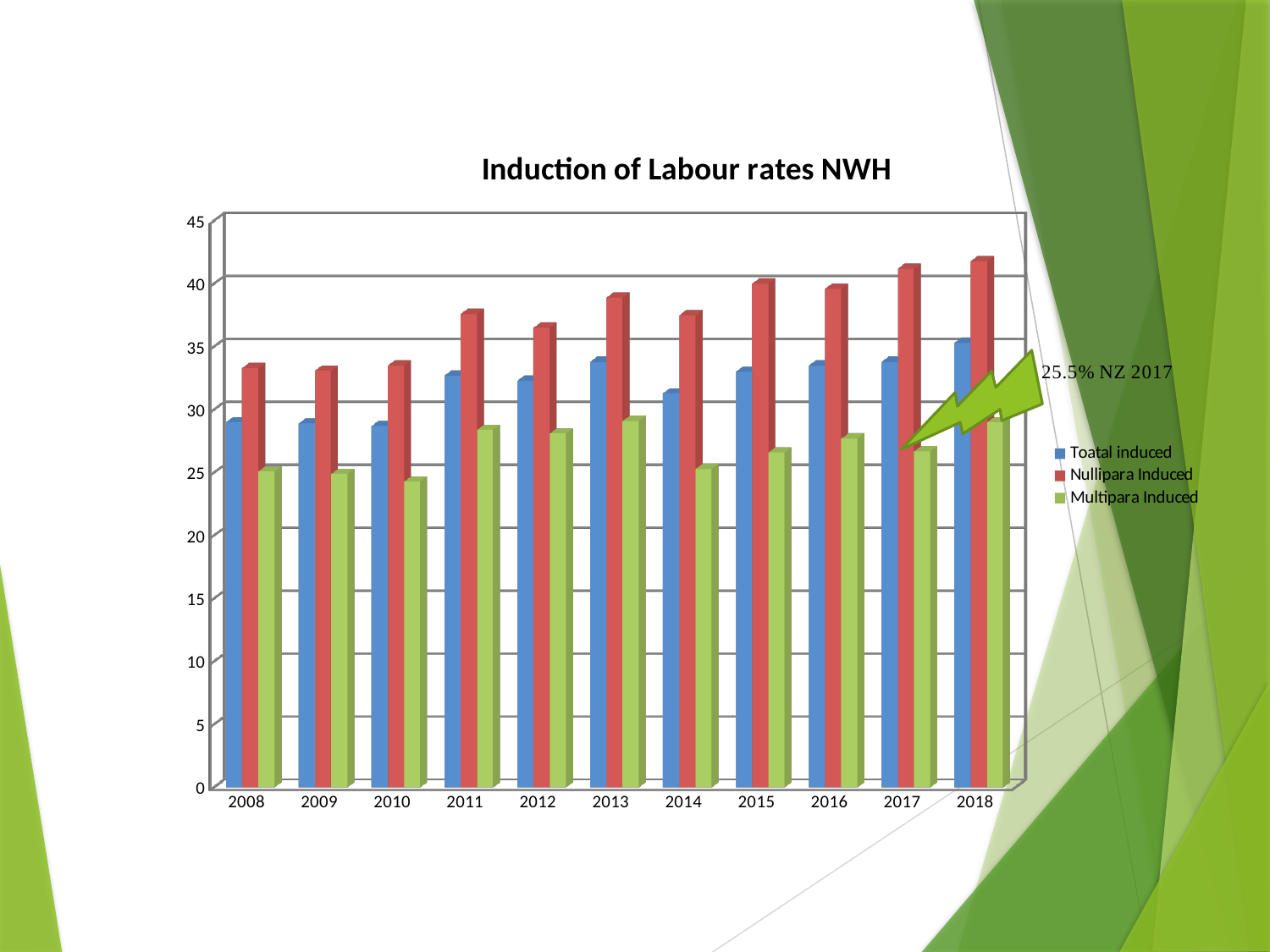
Which series is shown in red? Nullipara Induced In which year is the Toatal induced value highest? 2018 How many series does the legend list? 3 Is the value for Nullipara Induced in 2018 greater or less than 40? greater What kind of chart is shown on the slide? bar chart Is the value for Toatal induced in 2011 greater or less than 30? greater In which year is the Multipara Induced value lowest? 2010 How many years are shown on the x axis? 11 What is the title of the chart? Induction of Labour rates NWH Is the value for Nullipara Induced in 2008 greater or less than 35? less In 2013, which is larger: Nullipara Induced or Multipara Induced? Nullipara Induced